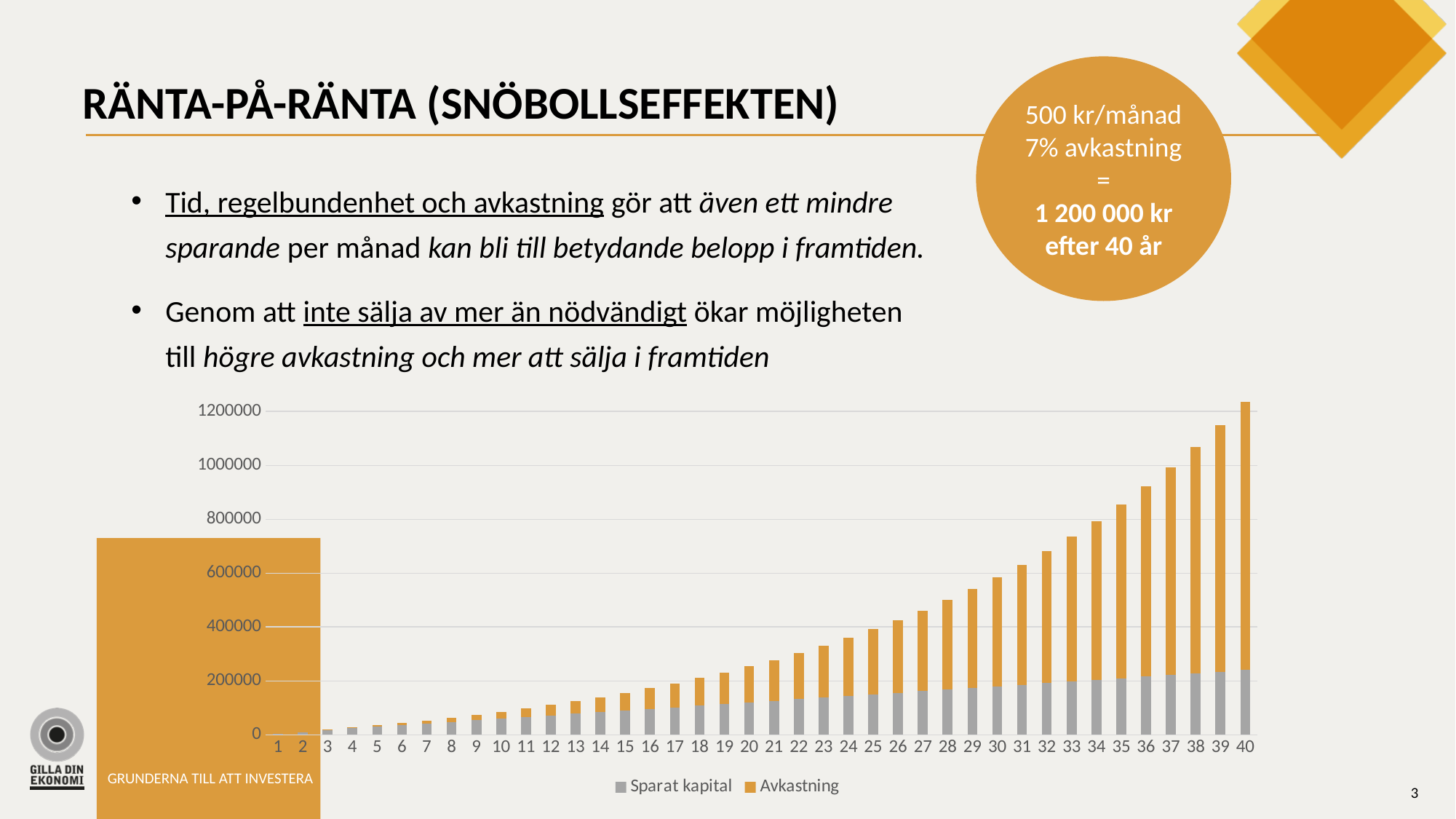
Which year has the highest total bar in the chart? 40 How many series does the chart legend list? 2 What kind of chart is shown on the slide? Stacked bar chart Which has the larger total bar, year 30 or year 40? 40 Do the total bar values rise or fall as the years increase along the x axis? Rise Is the total value for year 10 greater or less than 200000? less Is the total value for year 35 greater or less than 800000? greater Is the total value for year 40 greater or less than 1000000? greater Which year has the lowest total bar in the chart? 1 Which series is shown in orange in the chart legend? Avkastning How many categories (years) are shown on the x axis of the chart? 40